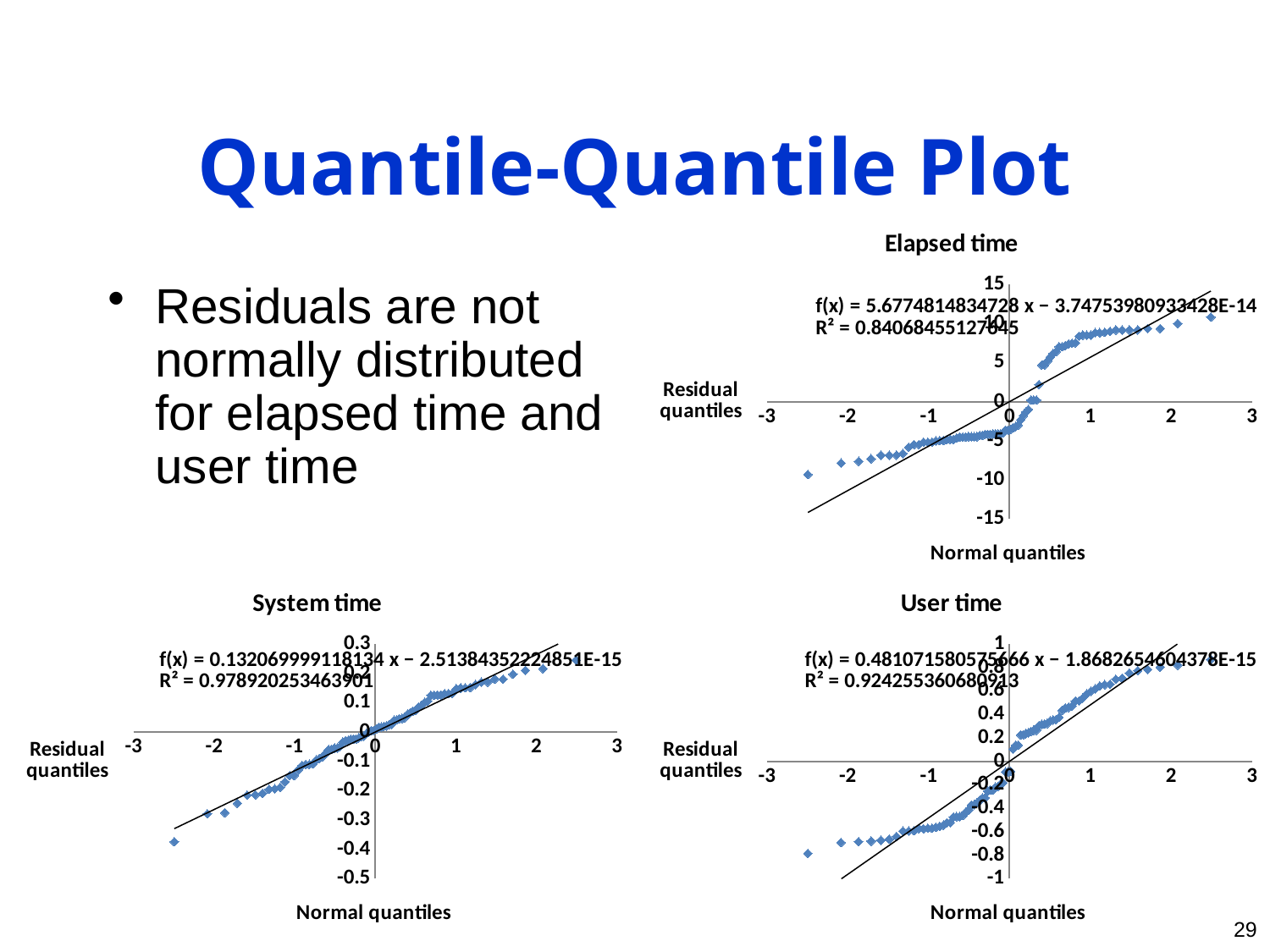
In the 'Elapsed time' chart, what is the slope coefficient in the trendline equation f(x)? 5.6774814834728 Which of the three charts shows the lowest R² value? Elapsed time In the 'User time' chart, do the residual quantiles rise or fall as the normal quantiles increase? rise In the 'Elapsed time' chart, is the residual quantile of the leftmost point greater or less than -5? less What is the x-axis title of the 'User time' chart? Normal quantiles What kind of chart is the 'Elapsed time' chart? scatter chart In the 'Elapsed time' chart, what is the R² value shown for the trendline? 0.84068455127845 In the 'System time' chart, what is the R² value shown for the trendline? 0.978920253463901 In the 'System time' chart, is the residual quantile of the rightmost point greater or less than 0.1? greater How many charts are shown on the slide? 3 In the 'User time' chart, what is the R² value shown for the trendline? 0.924255360680913 Which of the three charts shows the highest R² value? System time